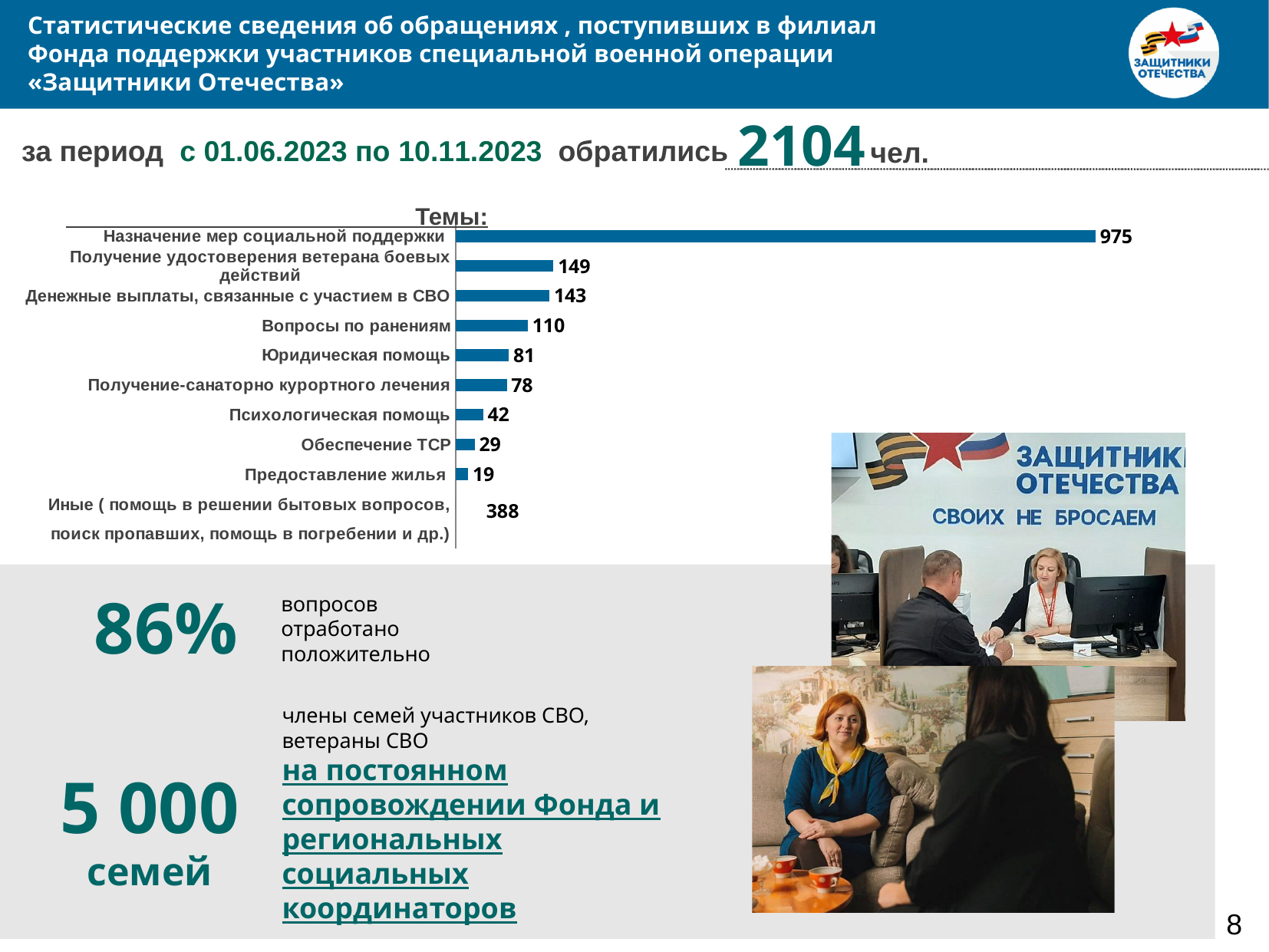
What is the value for "Вопросы по ранениям"? 110 What is the value for "Назначение мер социальной поддержки"? 975 What is the value for "Психологическая помощь"? 42 Which category has the lowest value in the chart? Предоставление жилья Which is larger: the value for "Юридическая помощь" or the value for "Обеспечение ТСР"? Юридическая помощь What is the value for "Иные ( помощь в решении бытовых вопросов, поиск пропавших, помощь в погребении и др.)"? 388 What is the title of the chart? Темы: How many categories are shown in the chart? 10 What is the difference between the values for "Получение удостоверения ветерана боевых действий" and "Денежные выплаты, связанные с участием в СВО"? 6 Which category has the highest value in the chart? Назначение мер социальной поддержки What is the value for "Предоставление жилья"? 19 What type of chart is shown under the heading "Темы:"? bar chart